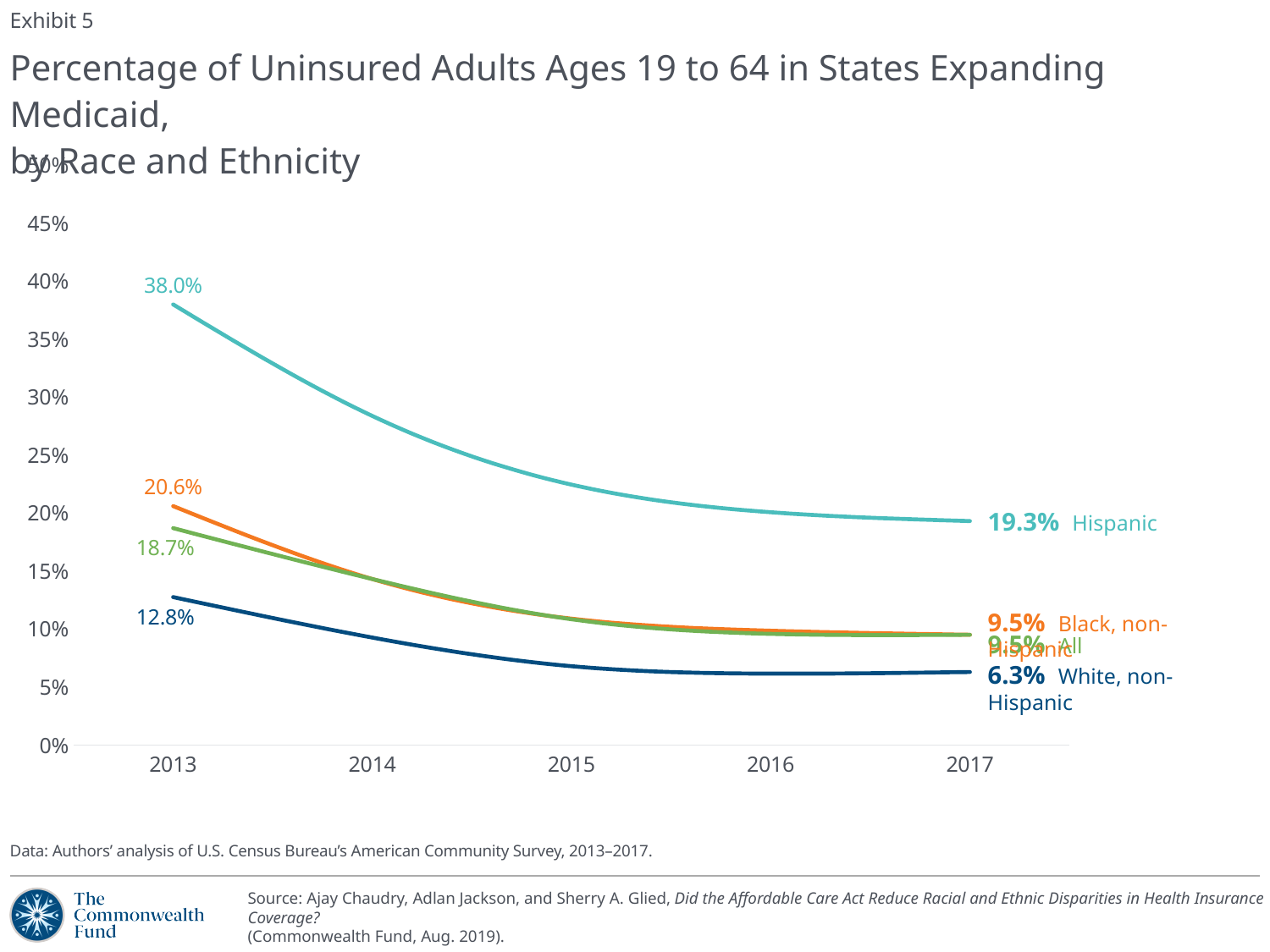
How many years are shown on the x axis? 5 What was the percentage of uninsured White, non-Hispanic adults in 2017? 6.3% What was the percentage of uninsured Black, non-Hispanic adults in 2013? 20.6% What was the percentage of uninsured Hispanic adults in 2017? 19.3% Which group had the highest uninsured percentage in 2017? Hispanic What was the percentage of uninsured White, non-Hispanic adults in 2013? 12.8% What type of chart is shown on the slide? line chart What was the uninsured percentage for All adults in 2013? 18.7% By how many percentage points did the Hispanic uninsured rate fall from 2013 to 2017? 18.7 percentage points Does the uninsured rate for White, non-Hispanic adults rise or fall from 2013 to 2017? fall What was the percentage of uninsured Hispanic adults in 2013? 38.0% Which group had the lowest uninsured percentage in 2013? White, non-Hispanic